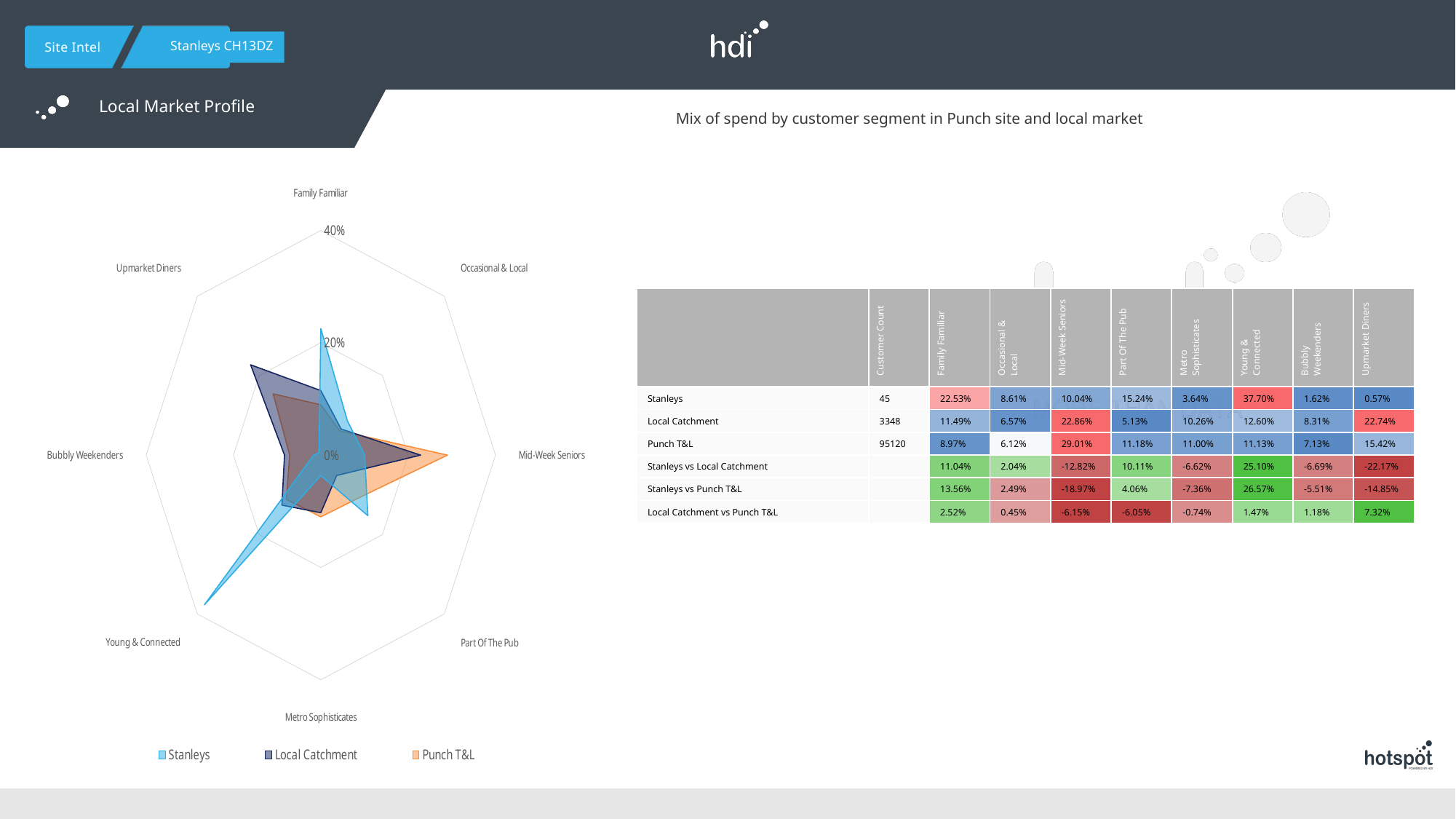
How many customer segment categories are plotted on the radar chart? 8 What is the Punch T&L value for Mid-Week Seniors? 29.01% What is the Stanleys value for Young & Connected? 37.70% Is the Punch T&L value for Metro Sophisticates greater or less than 20%? less How many series does the legend of the radar chart list? 3 Is the Stanleys value for Young & Connected greater or less than 20%? greater What is the difference between the Stanleys and Local Catchment values for Young & Connected? 25.10% Which customer segment has the highest value for Punch T&L? Mid-Week Seniors Which customer segment has the lowest value for Stanleys? Upmarket Diners What kind of chart is shown on the left of the slide? Radar chart Which customer segment has the highest value for Stanleys? Young & Connected For Mid-Week Seniors, which is larger: the Stanleys value or the Punch T&L value? Punch T&L